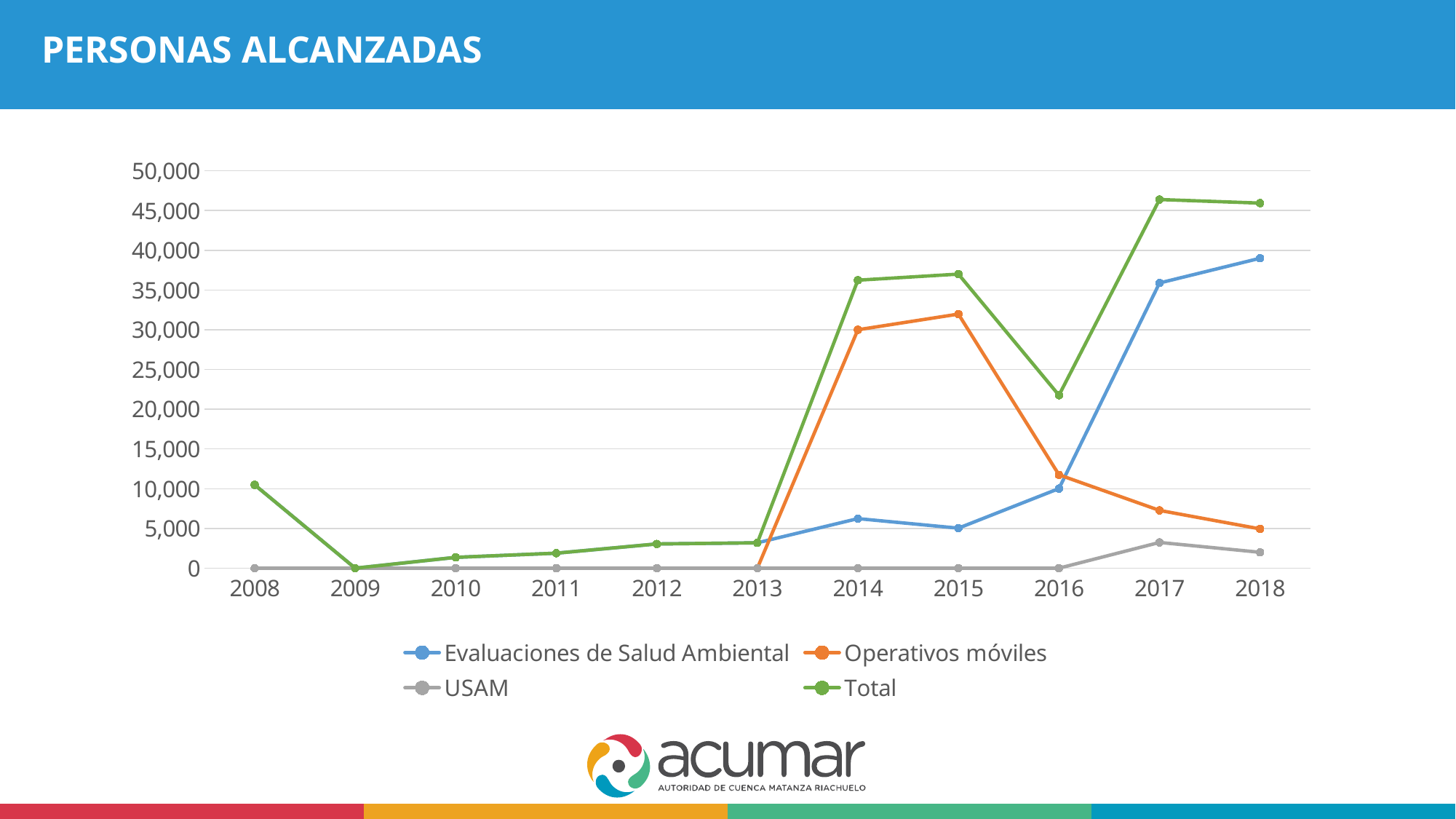
Is the Operativos móviles value for 2018 greater or less than 10,000? less In which year is the Total series at its lowest? 2009 In which year does the Evaluaciones de Salud Ambiental series reach its highest value? 2018 In 2015, which is larger: Operativos móviles or Evaluaciones de Salud Ambiental? Operativos móviles In which year does the Operativos móviles series reach its highest value? 2015 How many series does the legend list? 4 What is the title of the slide? PERSONAS ALCANZADAS Is the Total value for 2014 greater or less than 35,000? greater What kind of chart is shown on the slide? line chart How many years are shown on the x axis? 11 Is the Evaluaciones de Salud Ambiental value for 2016 greater or less than 15,000? less Does the Operativos móviles series rise or fall from 2015 to 2018? fall